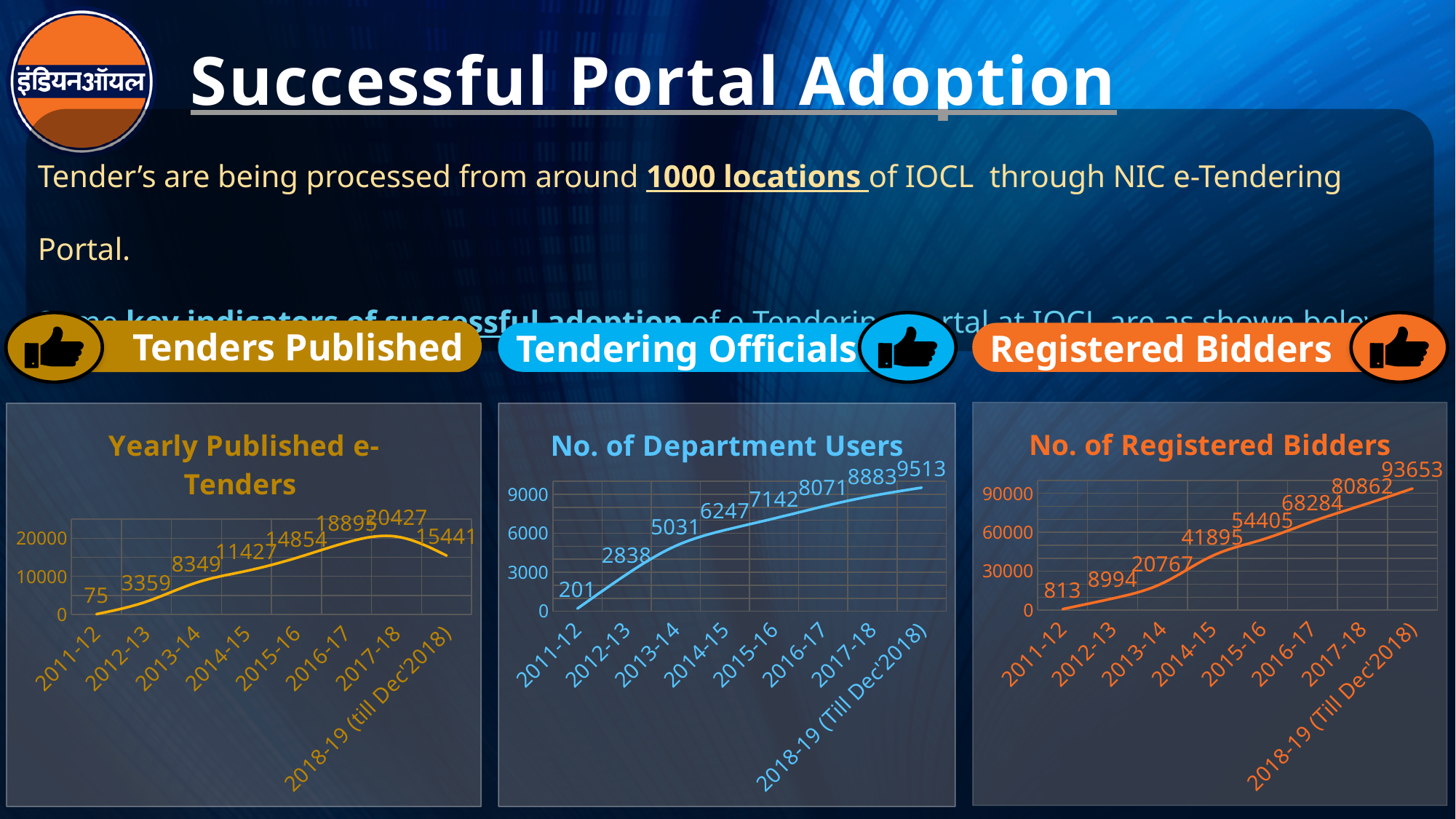
In the 'No. of Registered Bidders' chart, what is the value for 2014-15? 41895 In the 'No. of Department Users' chart, what is the value for 2013-14? 5031 In the 'Yearly Published e-Tenders' chart, which year has the highest value? 2017-18 In the 'No. of Registered Bidders' chart, what is the difference between the values for 2018-19 (Till Dec'2018) and 2017-18? 12791 How many data points are plotted in the 'No. of Registered Bidders' chart? 8 In the 'Yearly Published e-Tenders' chart, what is the value for 2018-19 (till Dec'2018)? 15441 In the 'No. of Department Users' chart, what is the value for 2018-19 (Till Dec'2018)? 9513 In the 'Yearly Published e-Tenders' chart, what is the difference between the values for 2017-18 and 2016-17? 1532 In the 'Yearly Published e-Tenders' chart, which year has the lowest value? 2011-12 In the 'No. of Department Users' chart, do the values rise or fall from 2011-12 to 2018-19? rise In the 'Yearly Published e-Tenders' chart, what is the value for 2017-18? 20427 In the 'No. of Registered Bidders' chart, which is larger, the value for 2013-14 or the value for 2012-13? 2013-14